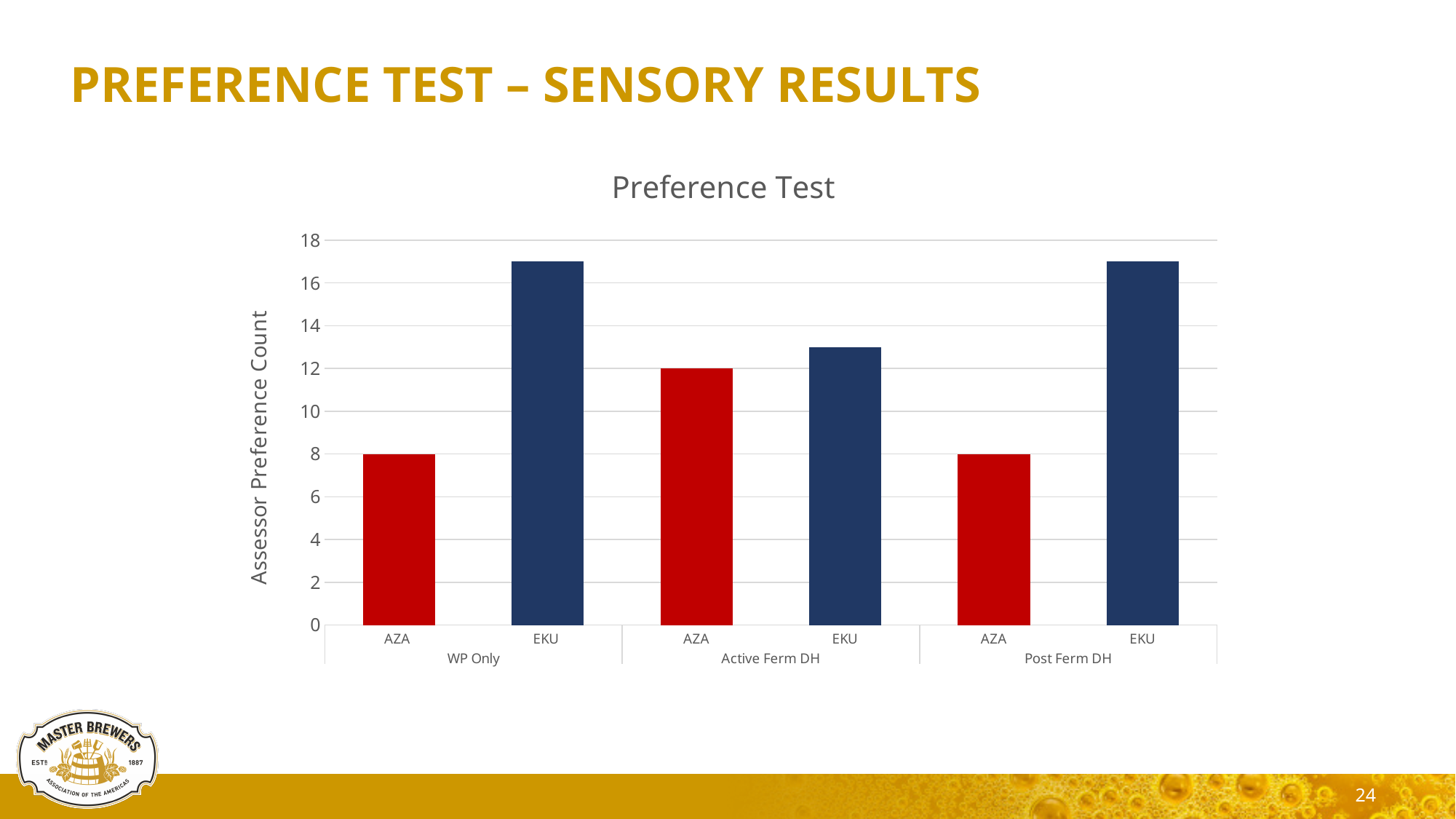
Is the value for EKU in the WP Only group greater or less than 16? greater What is the Assessor Preference Count for AZA in the Post Ferm DH group? 8 Is the value for EKU in the Post Ferm DH group greater or less than 16? greater In the WP Only group, which has the larger Assessor Preference Count, AZA or EKU? EKU What is the title of the chart? Preference Test Is the value for EKU in the Active Ferm DH group greater or less than 14? less What is the Assessor Preference Count for AZA in the Active Ferm DH group? 12 What is the Assessor Preference Count for AZA in the WP Only group? 8 In the Post Ferm DH group, which has the larger Assessor Preference Count, AZA or EKU? EKU What is the difference between the AZA value in the Active Ferm DH group and the AZA value in the WP Only group? 4 How many bars are plotted in the chart? 6 What kind of chart is shown on the slide? Bar chart